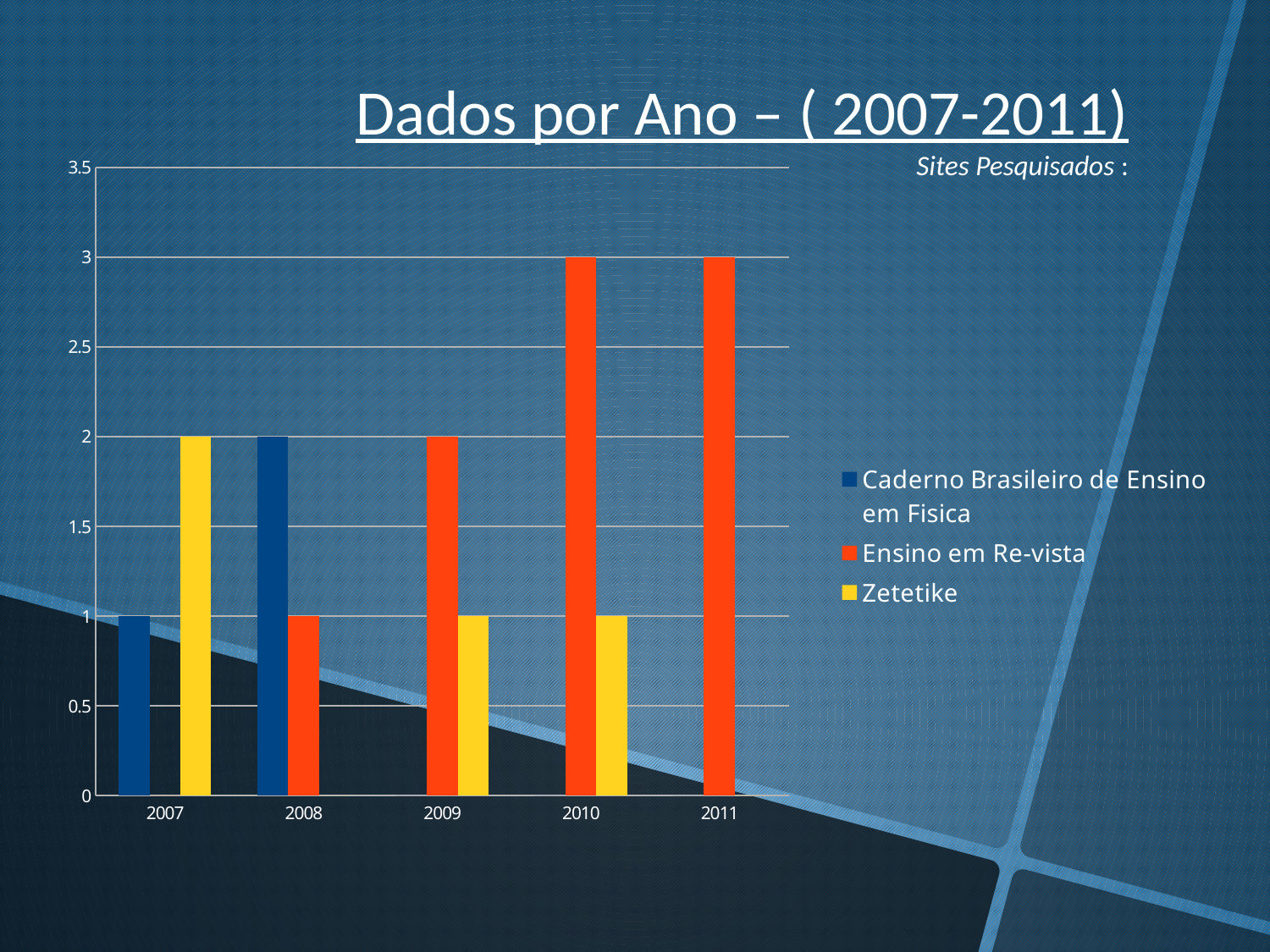
What is the value for Ensino em Re-vista in 2008? 1 How many series does the legend list? 3 What is the value for Caderno Brasileiro de Ensino em Fisica in 2008? 2 What is the title of the chart? Dados por Ano – ( 2007-2011) What kind of chart is shown on the slide? bar chart How many years are shown on the x axis? 5 What is the value for Ensino em Re-vista in 2010? 3 What is the value for Zetetike in 2007? 2 What is the difference between Ensino em Re-vista in 2011 and Ensino em Re-vista in 2009? 1 Does the value for Ensino em Re-vista rise or fall from 2008 to 2010? rise In which year does Ensino em Re-vista first reach 3? 2010 Which is larger in 2009, Ensino em Re-vista or Zetetike? Ensino em Re-vista